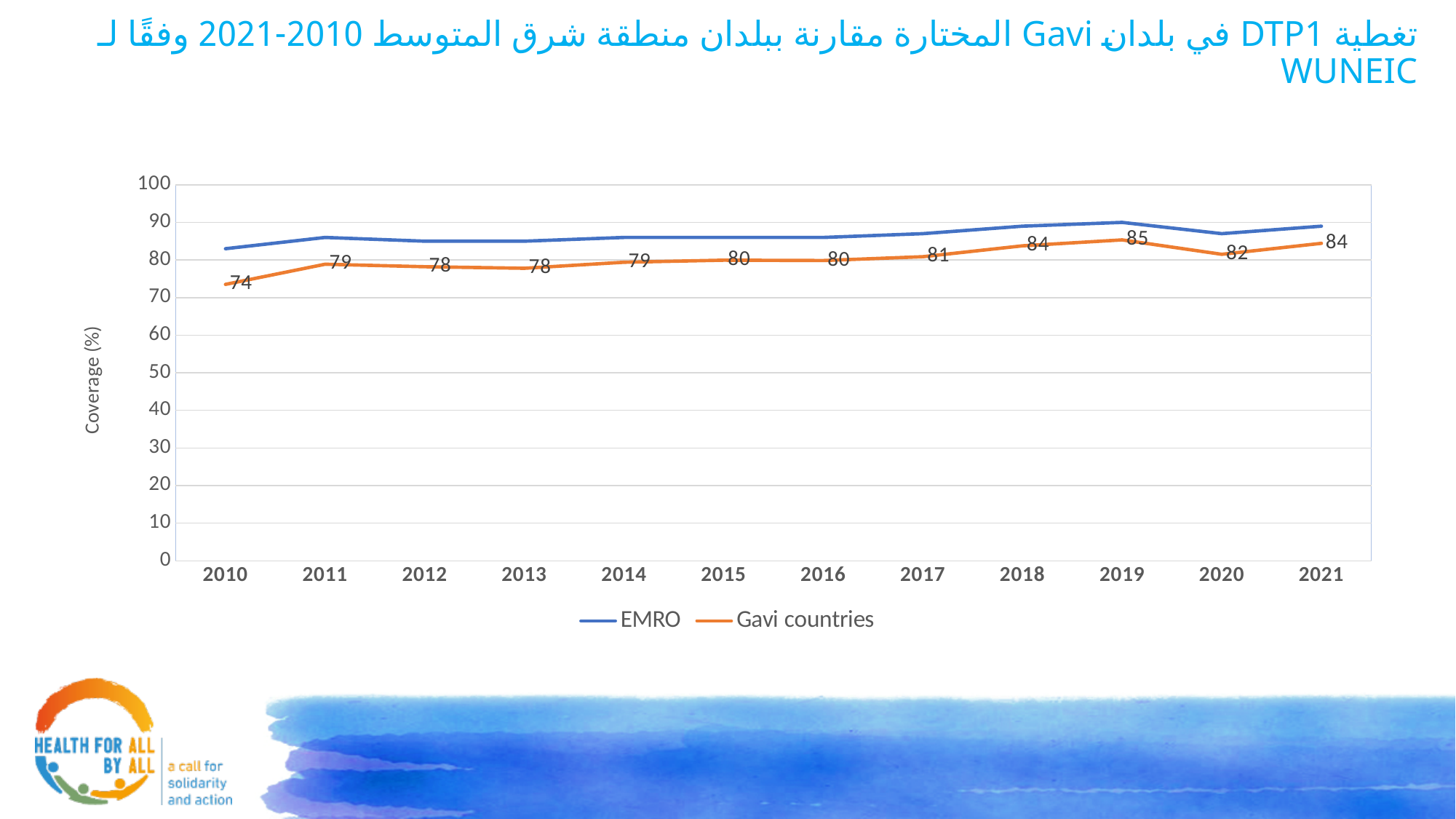
Do the Gavi countries values rise or fall from 2010 to 2019? rise How many years are shown on the x axis? 12 What is the value for Gavi countries in 2020? 82 In which year is the Gavi countries value highest? 2019 Is the value for EMRO in 2010 greater or less than 80? greater What is the value for Gavi countries in 2019? 85 In which year is the Gavi countries value lowest? 2010 How many series does the legend list? 2 What is the difference between the Gavi countries values for 2021 and 2010? 10 What is the value for Gavi countries in 2010? 74 In 2020, which series has the higher value, EMRO or Gavi countries? EMRO What kind of chart is shown on the slide? line chart